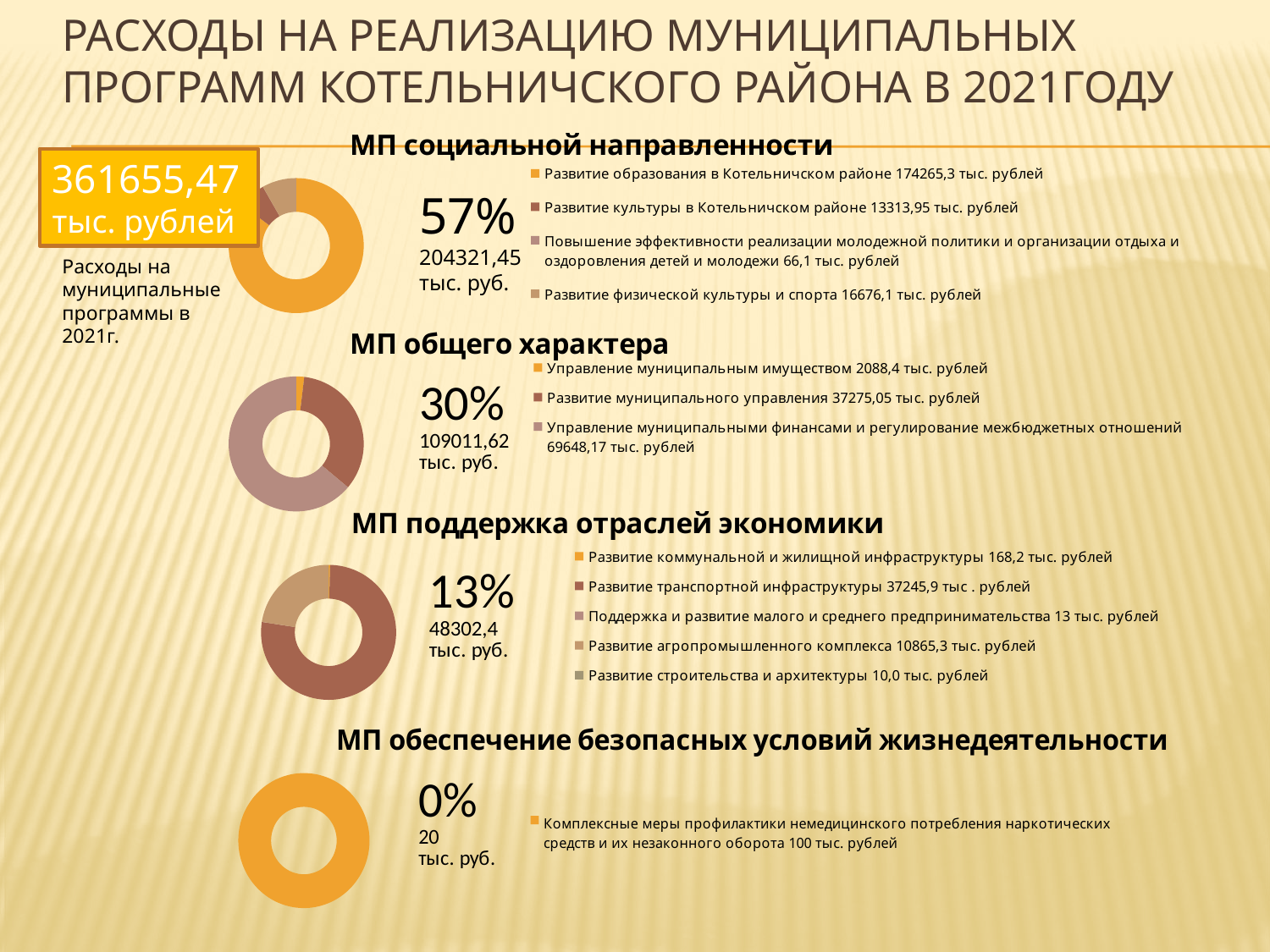
What share of total expenditure does «МП социальной направленности» account for, according to the slide? 57% What kind of chart is used for «МП социальной направленности»? Doughnut (pie) chart In the «МП поддержка отраслей экономики» chart, which is larger: «Развитие транспортной инфраструктуры» or «Развитие агропромышленного комплекса»? Развитие транспортной инфраструктуры In the «МП общего характера» chart, which category has the highest value? Управление муниципальными финансами и регулирование межбюджетных отношений In the «МП социальной направленности» chart, what is the value for «Развитие образования в Котельничском районе»? 174265,3 тыс. рублей In the «МП социальной направленности» chart, which category has the lowest value? Повышение эффективности реализации молодежной политики и организации отдыха и оздоровления детей и молодежи In the «МП социальной направленности» chart, how many categories does the legend list? 4 In the «МП общего характера» chart, what is the value for «Развитие муниципального управления»? 37275,05 тыс. рублей What total amount of expenditure on municipal programmes in 2021 is shown in the box at the top left of the slide? 361655,47 тыс. рублей In the «МП общего характера» chart, how many categories does the legend list? 3 What total amount is shown next to the «МП поддержка отраслей экономики» chart? 48302,4 тыс. руб. In the «МП поддержка отраслей экономики» chart, what is the difference between «Развитие коммунальной и жилищной инфраструктуры» (168,2) and «Поддержка и развитие малого и среднего предпринимательства» (13)? 155,2 тыс. рублей